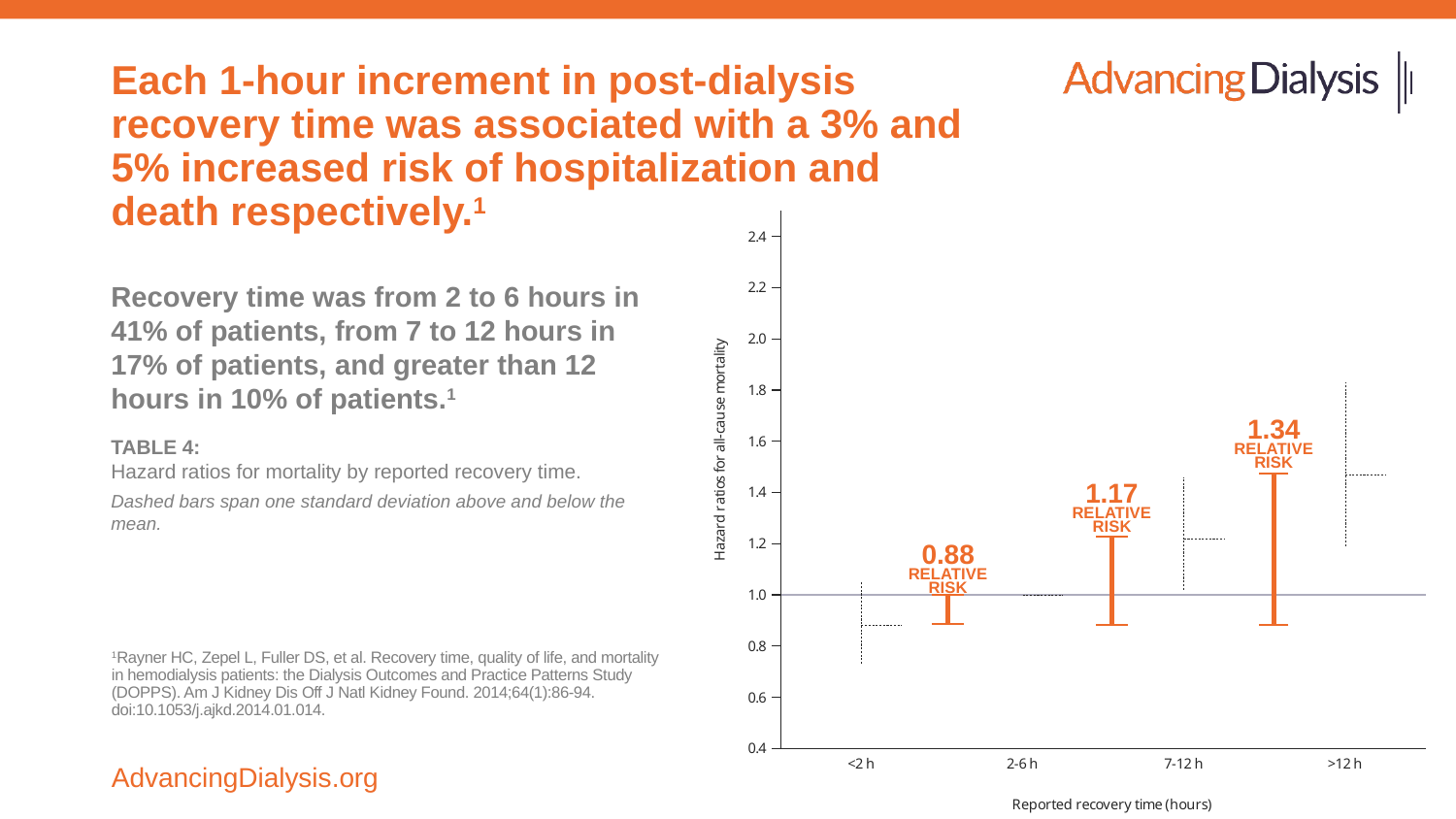
What is the title of the y axis of the chart? Hazard ratios for all-cause mortality What is the title of the x axis of the chart? Reported recovery time (hours) How many recovery-time categories are shown on the x axis? 4 What is the lowest relative risk value labeled on the chart? 0.88 Is the relative risk labeled 0.88 greater or less than 1.0? less What is the difference between the relative risk labeled 1.34 and the one labeled 1.17? 0.17 How many relative risk values are labeled on the chart? 3 What is the highest relative risk value labeled on the chart? 1.34 Is the relative risk labeled 1.34 greater or less than 1.2? greater Which is larger, the relative risk labeled for the longest recovery time (>12 h) or the one for the shortest (<2 h)? >12 h (1.34) Do the labeled relative risk values rise or fall as reported recovery time increases along the x axis? rise What is the difference between the highest labeled relative risk (1.34) and the lowest labeled relative risk (0.88)? 0.46